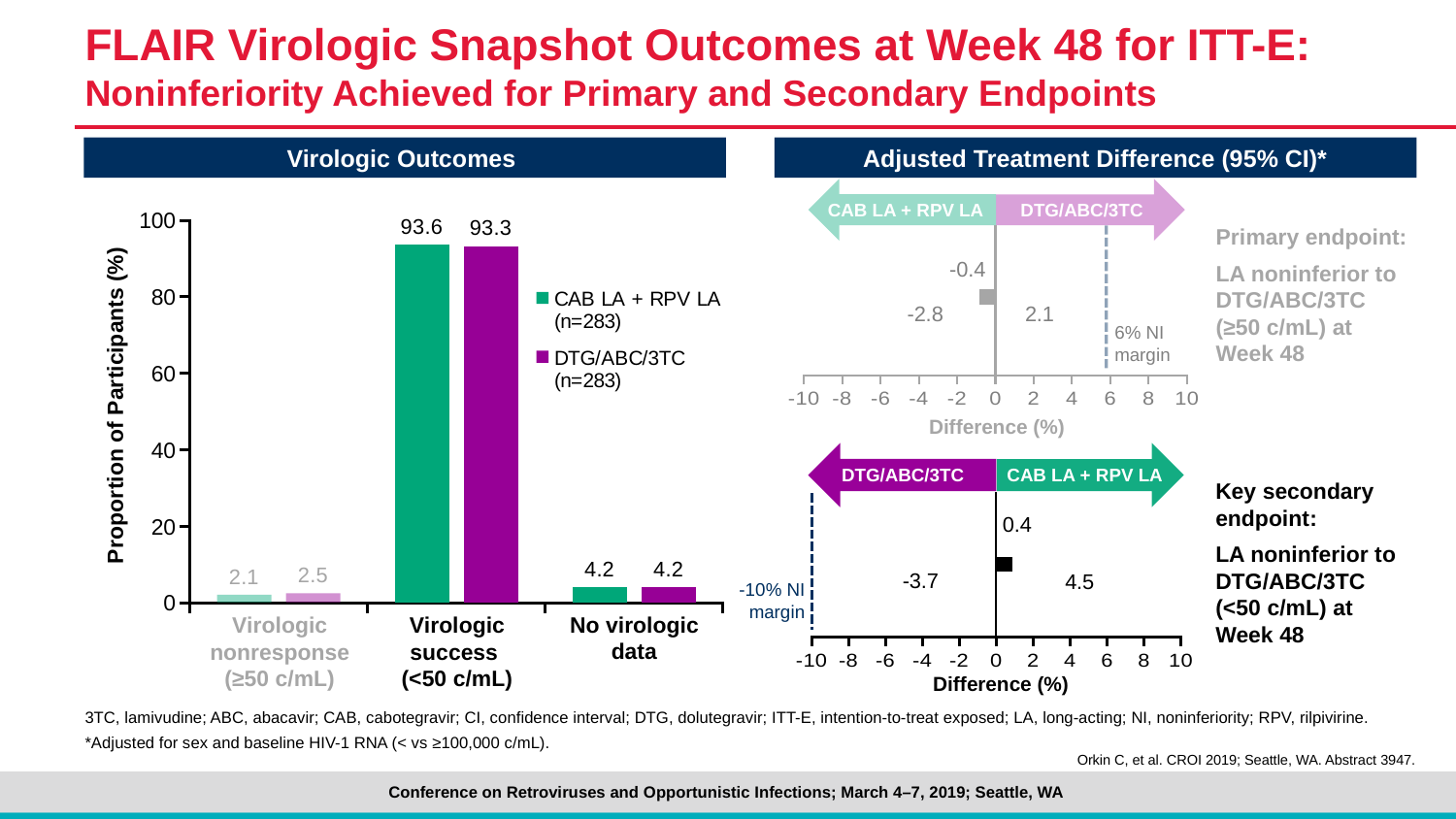
In the Virologic Outcomes chart, what is the value for DTG/ABC/3TC in the Virologic nonresponse (≥50 c/mL) category? 2.5 In the Adjusted Treatment Difference chart for the primary endpoint (≥50 c/mL), what is the point estimate of the difference? -0.4 In the Virologic Outcomes chart, is the value for CAB LA + RPV LA in the Virologic success category greater or less than 80? greater In the Virologic Outcomes chart, what is the value for CAB LA + RPV LA in the Virologic success (<50 c/mL) category? 93.6 In the Virologic Outcomes chart, what is the difference between the CAB LA + RPV LA and DTG/ABC/3TC values for Virologic success (<50 c/mL)? 0.3 In the Virologic Outcomes chart, what is the value for DTG/ABC/3TC in the No virologic data category? 4.2 In the Adjusted Treatment Difference chart for the key secondary endpoint (<50 c/mL), what is the upper bound of the 95% CI? 4.5 In the Virologic Outcomes chart, how many categories are shown on the x axis? 3 In the Virologic Outcomes chart, how many series does the legend list? 2 What kind of chart is the Virologic Outcomes chart? Bar chart In the Virologic Outcomes chart, which category has the highest value for CAB LA + RPV LA? Virologic success (<50 c/mL) In the Virologic Outcomes chart, which category has the lowest value for DTG/ABC/3TC? Virologic nonresponse (≥50 c/mL)